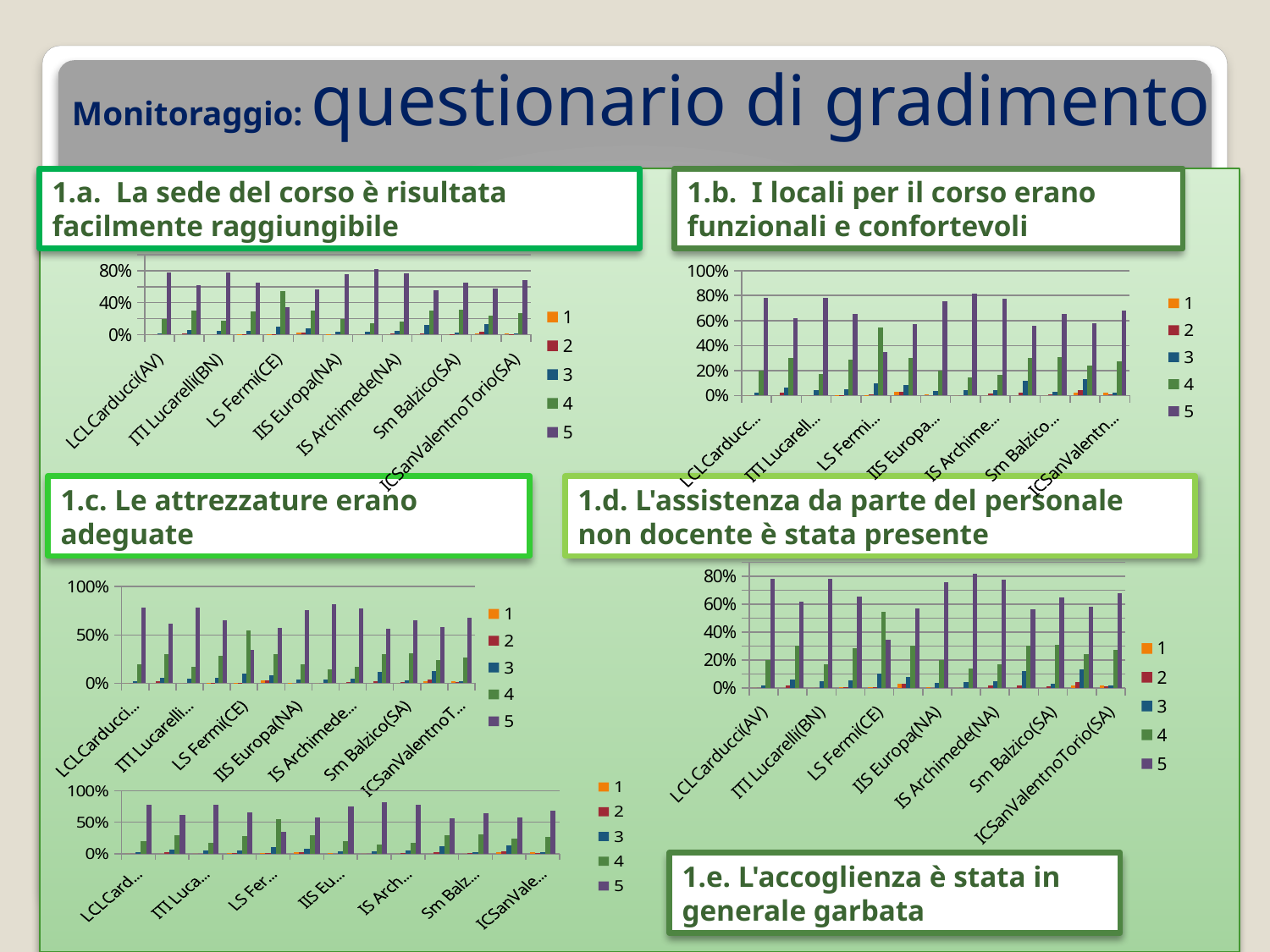
What is the highest value shown on the y axis of the chart for 1.b 'I locali per il corso erano funzionali e confortevoli'? 100% In the chart for 1.b 'I locali per il corso erano funzionali e confortevoli', is the value of series 5 for LCLCarducci greater or less than 60%? greater What kind of chart is used for question 1.a 'La sede del corso è risultata facilmente raggiungibile'? bar chart How many series does the legend list in the chart for 1.b 'I locali per il corso erano funzionali e confortevoli'? 5 In the chart for 1.b 'I locali per il corso erano funzionali e confortevoli', which is larger for LCLCarducci: series 4 or series 5? 5 In the chart for 1.b 'I locali per il corso erano funzionali e confortevoli', which series has the highest value for LCLCarducci? 5 In the chart for 1.a 'La sede del corso è risultata facilmente raggiungibile', is the value of series 5 for LCLCarducci(AV) greater or less than 40%? greater In the chart for 1.d 'L'assistenza da parte del personale non docente è stata presente', which is larger for LCLCarducci(AV): series 1 or series 5? 5 In the chart for 1.c 'Le attrezzature erano adeguate', which series has the highest value for LCLCarducci? 5 What are the legend entries in the chart for 1.a 'La sede del corso è risultata facilmente raggiungibile'? 1, 2, 3, 4, 5 In the chart for 1.c 'Le attrezzature erano adeguate', is the value of series 5 for LCLCarducci greater or less than 50%? greater